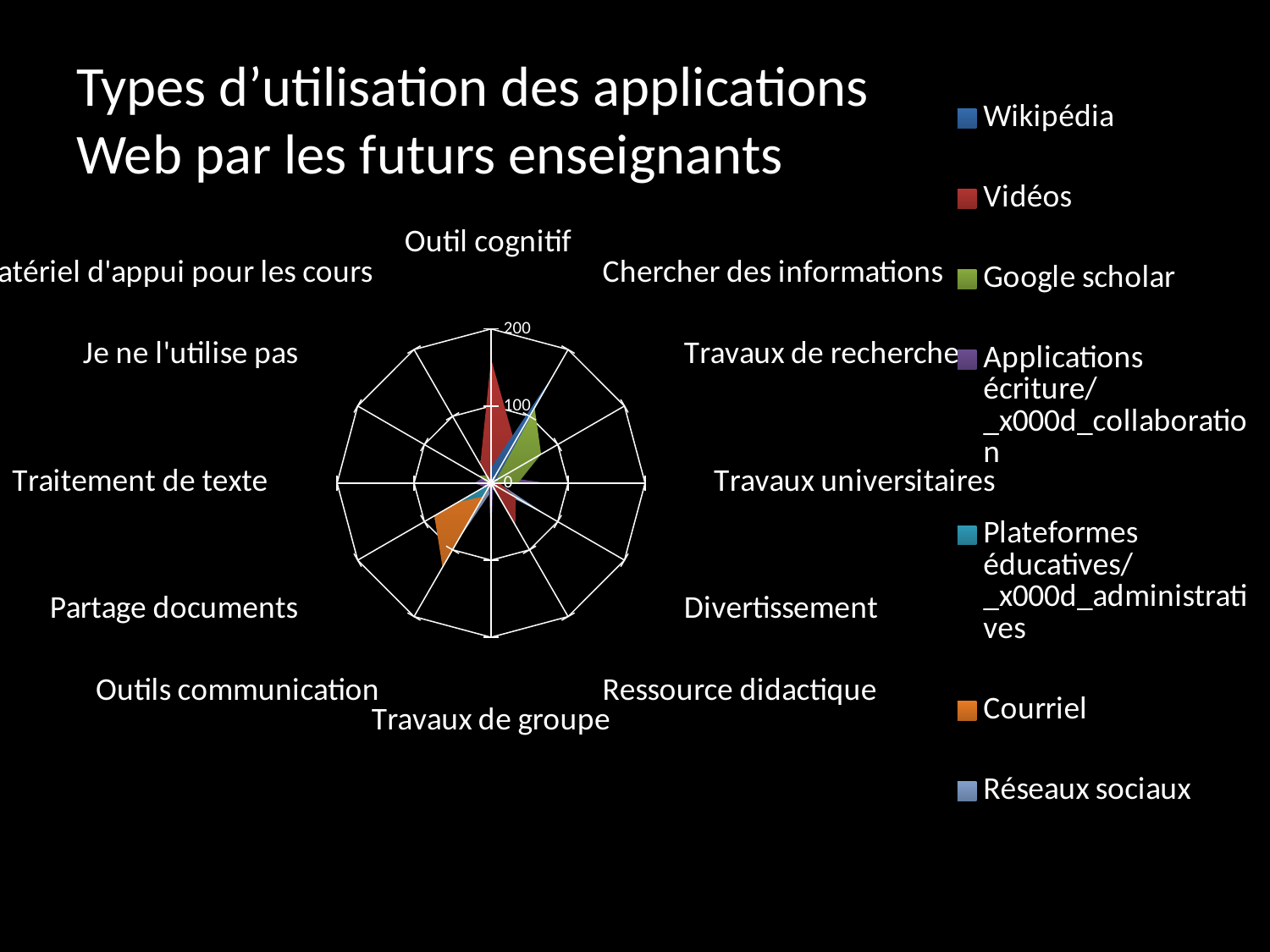
How many series does the legend list? 7 What is the title of the slide containing the chart? Types d'utilisation des applications Web par les futurs enseignants Is the value for Vidéos at Ressource didactique greater or less than 100? less For the Courriel series, which category has the highest value? Outils communication Is the value for Courriel at Partage documents greater or less than 200? less How many categories (axes) does the radar chart have? 12 What is the highest value shown on the radar chart's axis scale? 200 Which series is drawn in red? Vidéos What kind of chart is shown on the slide? Radar chart For the Vidéos series, which category has the highest value? Outil cognitif Is the value for Vidéos at Outil cognitif greater or less than 100? greater